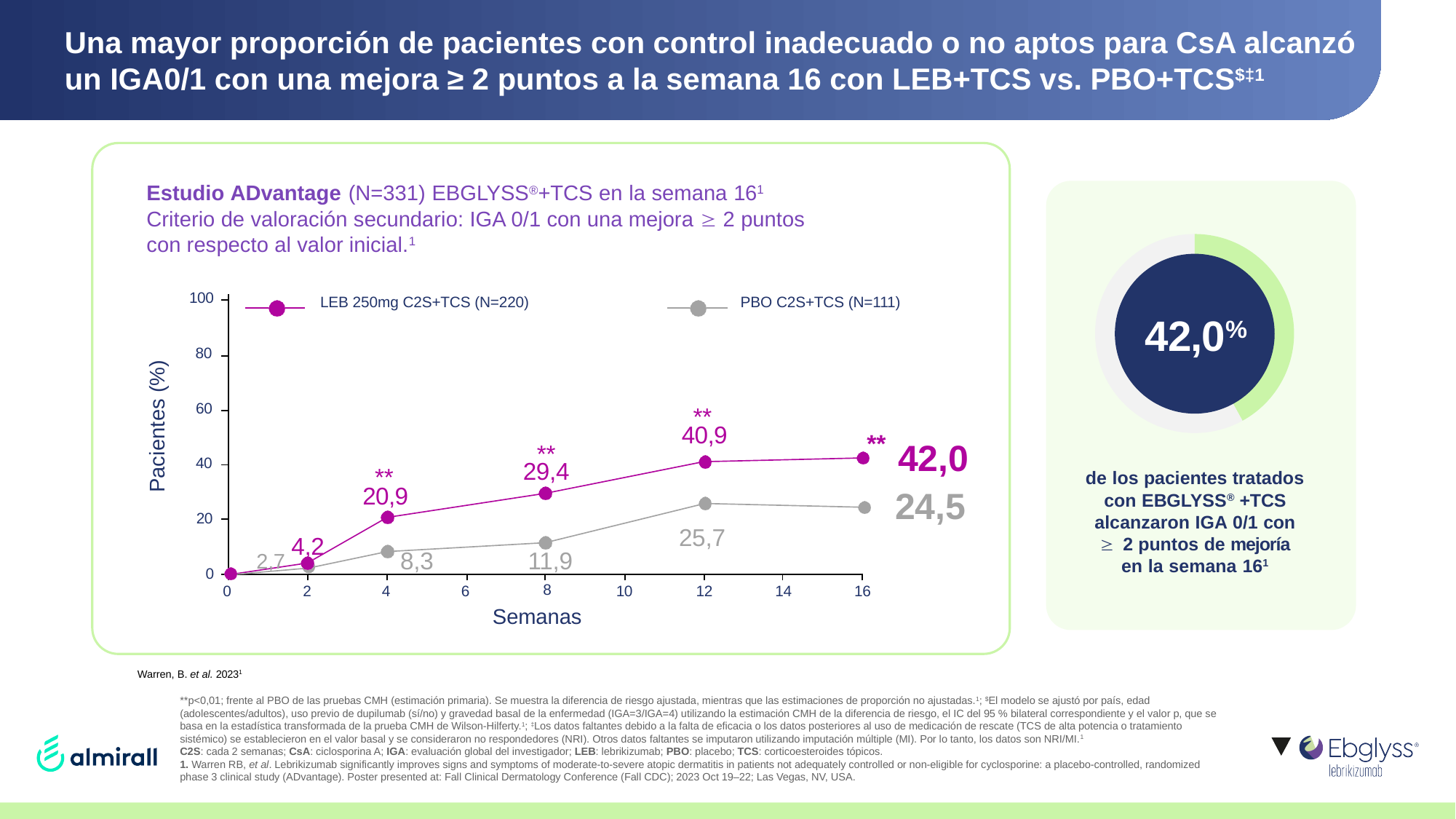
In the line chart, which series has the higher value at week 12? LEB 250mg C2S+TCS (N=220) What kind of chart is shown inside the green-bordered panel? Line chart In the line chart, does the LEB 250mg C2S+TCS series rise or fall from week 0 to week 16? Rise What percentage is shown in the donut chart on the right of the slide? 42,0% In the line chart, what is the difference between LEB 250mg C2S+TCS and PBO C2S+TCS at week 16? 17,5 In the line chart, what is the value for LEB 250mg C2S+TCS at week 16? 42,0 In the line chart, what is the label of the y axis? Pacientes (%) In the line chart, how many series does the legend list? 2 In the line chart, at which week does the LEB 250mg C2S+TCS series reach its highest value? 16 In the line chart, what is the value for LEB 250mg C2S+TCS at week 4? 20,9 In the line chart, what is the value for PBO C2S+TCS at week 12? 25,7 In the line chart, what is the value for PBO C2S+TCS at week 8? 11,9